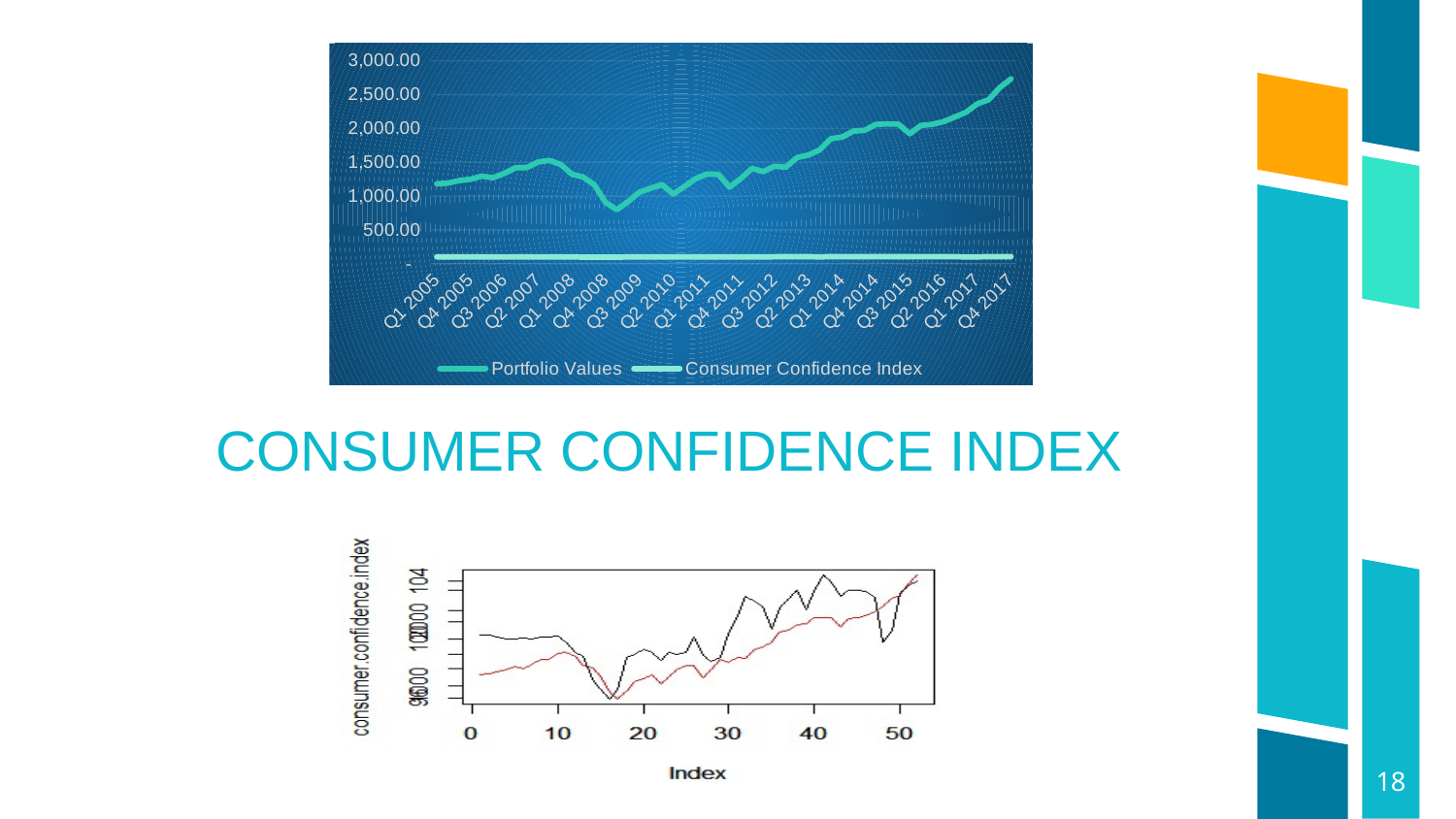
What kind of chart is the bottom chart on the slide? line chart In the top chart, which series has the higher values, Portfolio Values or Consumer Confidence Index? Portfolio Values In the top chart, is the Portfolio Values value for Q4 2017 greater or less than 2,500.00? greater What is the x-axis label of the bottom chart? Index What kind of chart is the top chart on the slide? line chart In the bottom chart, do the plotted values generally rise or fall as Index increases from 0 to 50? rise In the top chart, is the Consumer Confidence Index line greater or less than 500.00 across the period? less How many series does the legend of the top chart list? 2 In the top chart, do the Portfolio Values generally rise or fall from Q1 2005 to Q4 2017? rise In the top chart, what is the first category label on the x axis? Q1 2005 What are the two series named in the legend of the top chart? Portfolio Values and Consumer Confidence Index